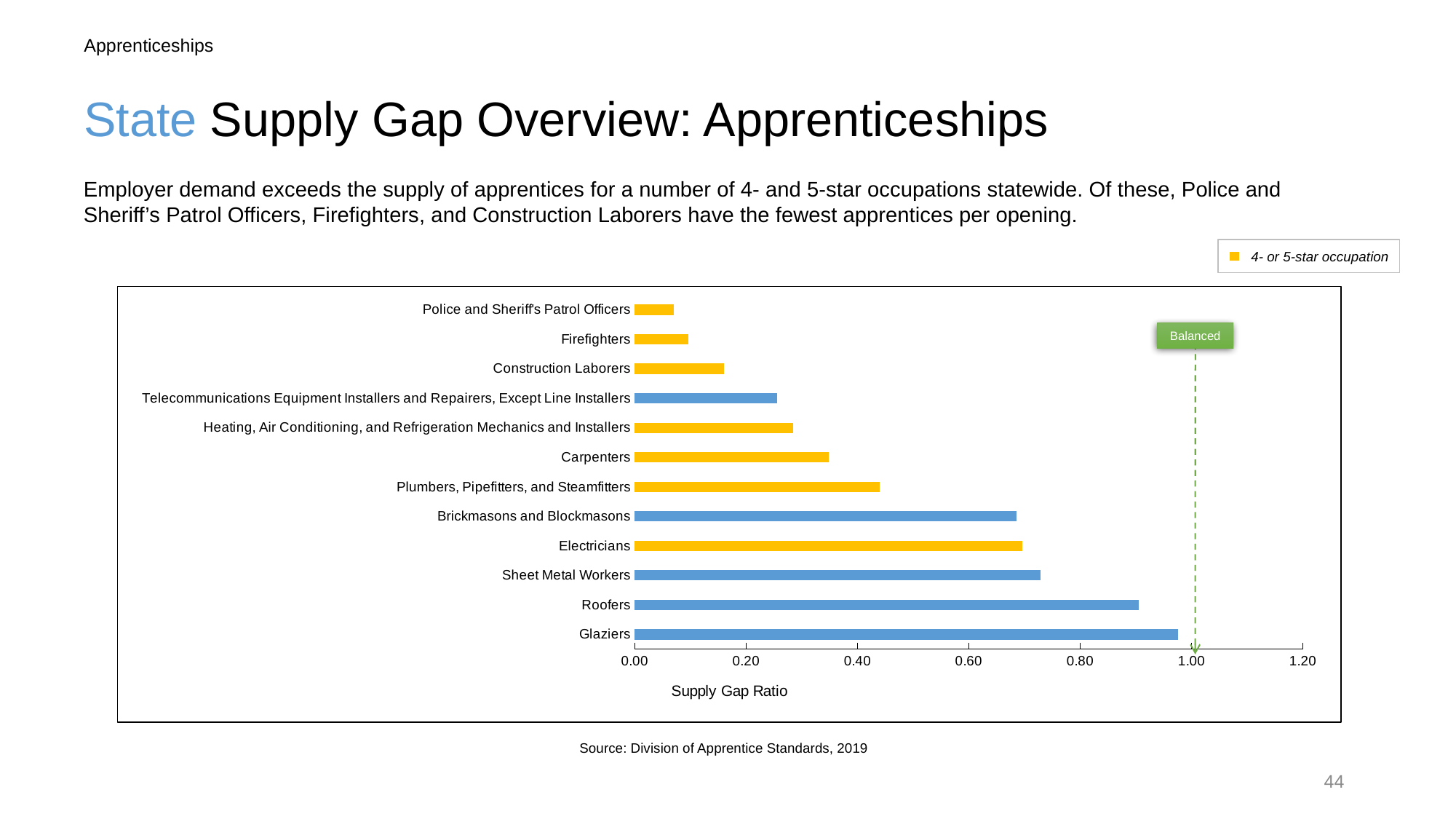
Is the supply gap ratio for Construction Laborers greater or less than 0.20? less Is the supply gap ratio for Sheet Metal Workers greater or less than 0.80? less What kind of chart is shown on the slide? Bar chart Is the supply gap ratio for Electricians greater or less than 0.60? greater How many occupations are plotted in the chart? 12 At what value on the axis is the dashed 'Balanced' line drawn? 1.00 Which has a larger supply gap ratio, Sheet Metal Workers or Plumbers, Pipefitters, and Steamfitters? Sheet Metal Workers Which has a larger supply gap ratio, Roofers or Carpenters? Roofers Which occupation has the lowest supply gap ratio? Police and Sheriff's Patrol Officers Which occupation has the highest supply gap ratio? Glaziers What is the title of the horizontal axis? Supply Gap Ratio